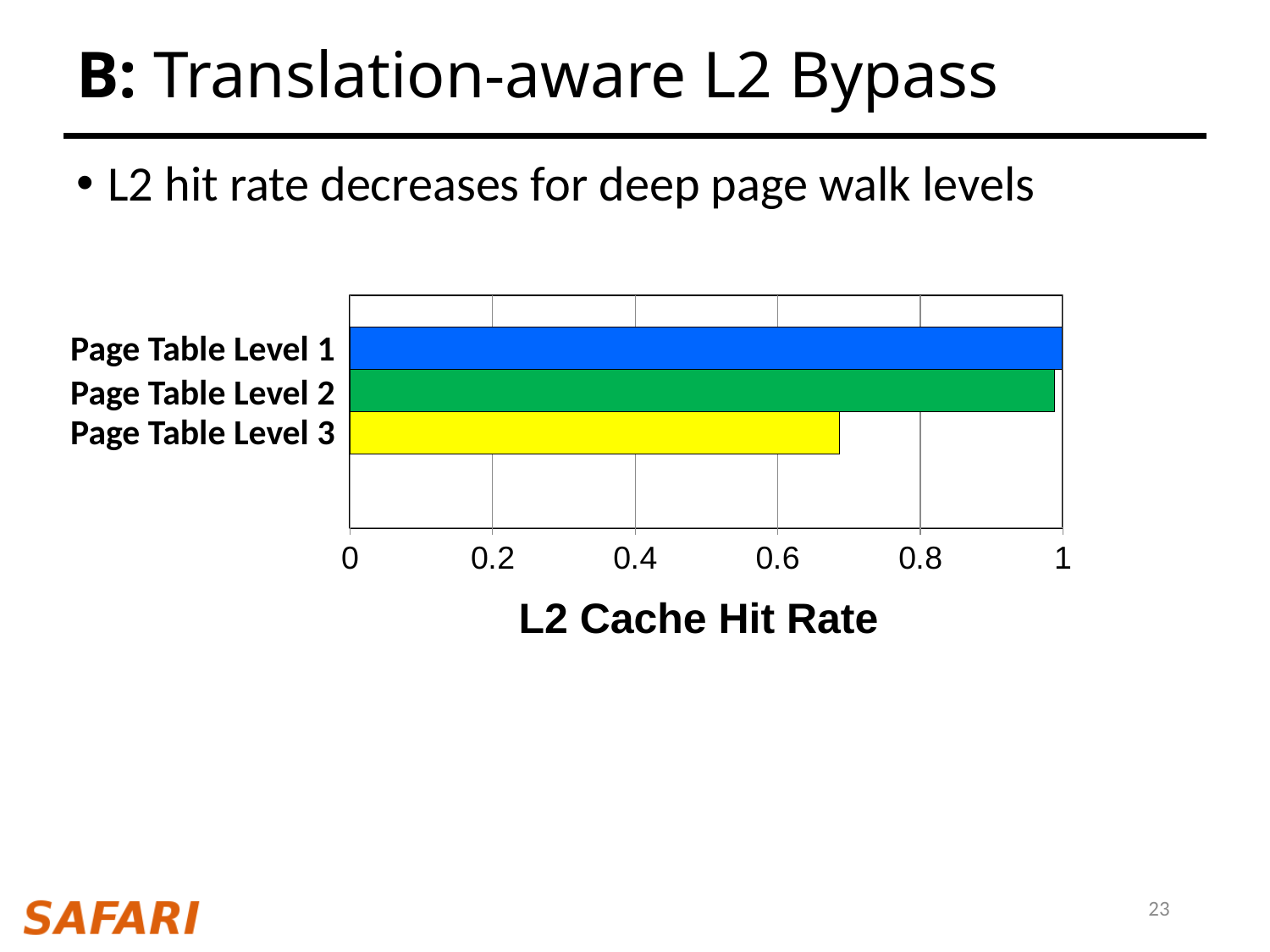
What is the title of the horizontal axis of the chart? L2 Cache Hit Rate What kind of chart is shown on the slide? bar chart Does the L2 cache hit rate increase or decrease going from Page Table Level 1 to Page Table Level 3? decrease Is the L2 cache hit rate for Page Table Level 3 greater or less than 0.6? greater Which has a higher L2 cache hit rate, Page Table Level 1 or Page Table Level 3? Page Table Level 1 Is the L2 cache hit rate for Page Table Level 1 greater or less than 0.8? greater What colour is the bar for Page Table Level 3? yellow How many page table levels are plotted in the chart? 3 Which page table level has the lowest L2 cache hit rate? Page Table Level 3 Is the L2 cache hit rate for Page Table Level 3 greater or less than 0.8? less Which has a higher L2 cache hit rate, Page Table Level 2 or Page Table Level 3? Page Table Level 2